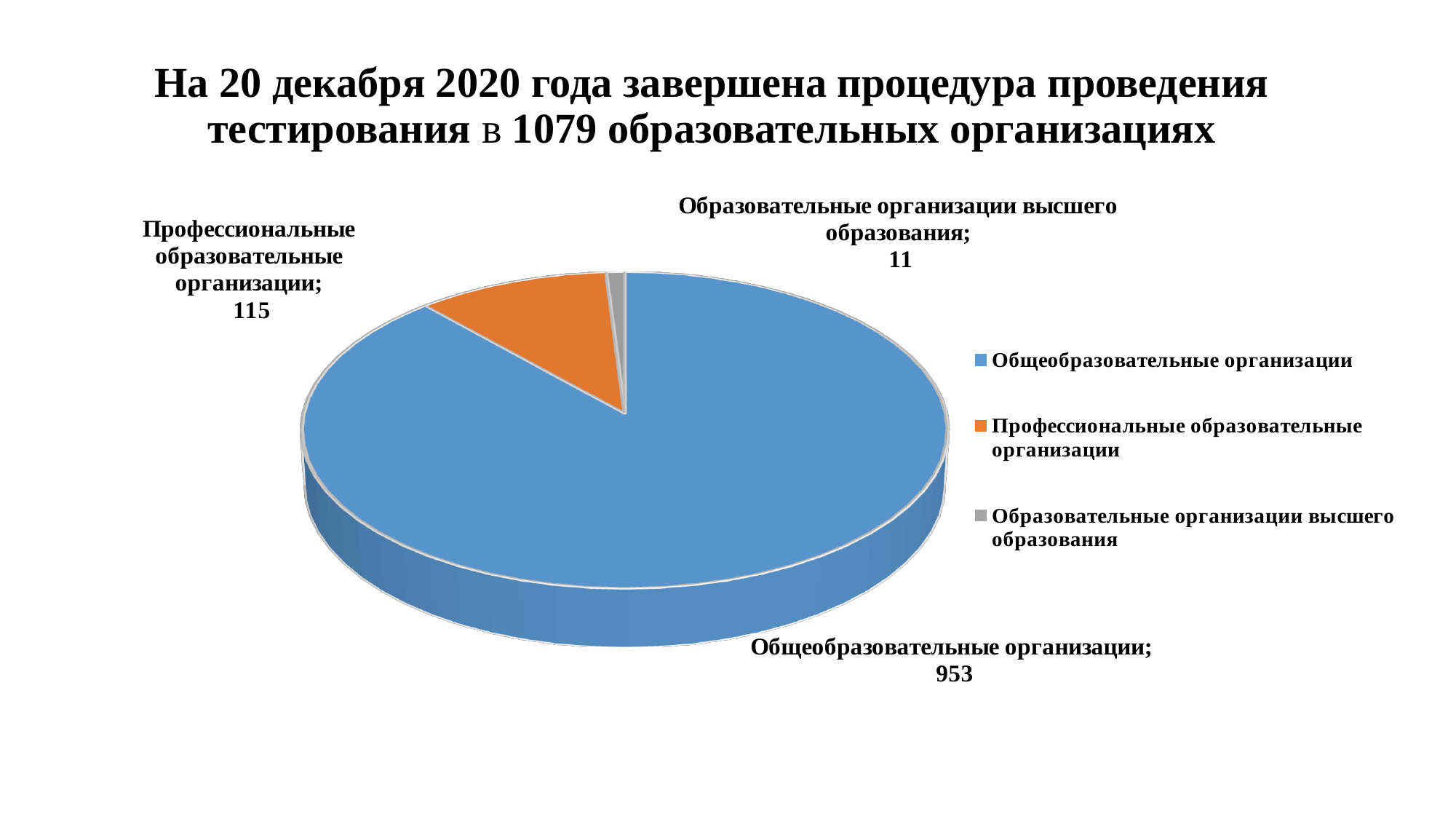
What is the value for Общеобразовательные организации? 953 Which is larger: the value for Профессиональные образовательные организации or the value for Образовательные организации высшего образования? Профессиональные образовательные организации What is the value for Профессиональные образовательные организации? 115 Which category has the largest slice of the pie? Общеобразовательные организации What is the value for Образовательные организации высшего образования? 11 Which category has the smallest slice of the pie? Образовательные организации высшего образования How many slices does the pie chart have? 3 What colour is the slice for Профессиональные образовательные организации? Orange What is the difference between the values for Профессиональные образовательные организации and Образовательные организации высшего образования? 104 What is the difference between the values for Общеобразовательные организации and Профессиональные образовательные организации? 838 How many entries does the legend list? 3 What type of chart is shown on the slide? Pie chart